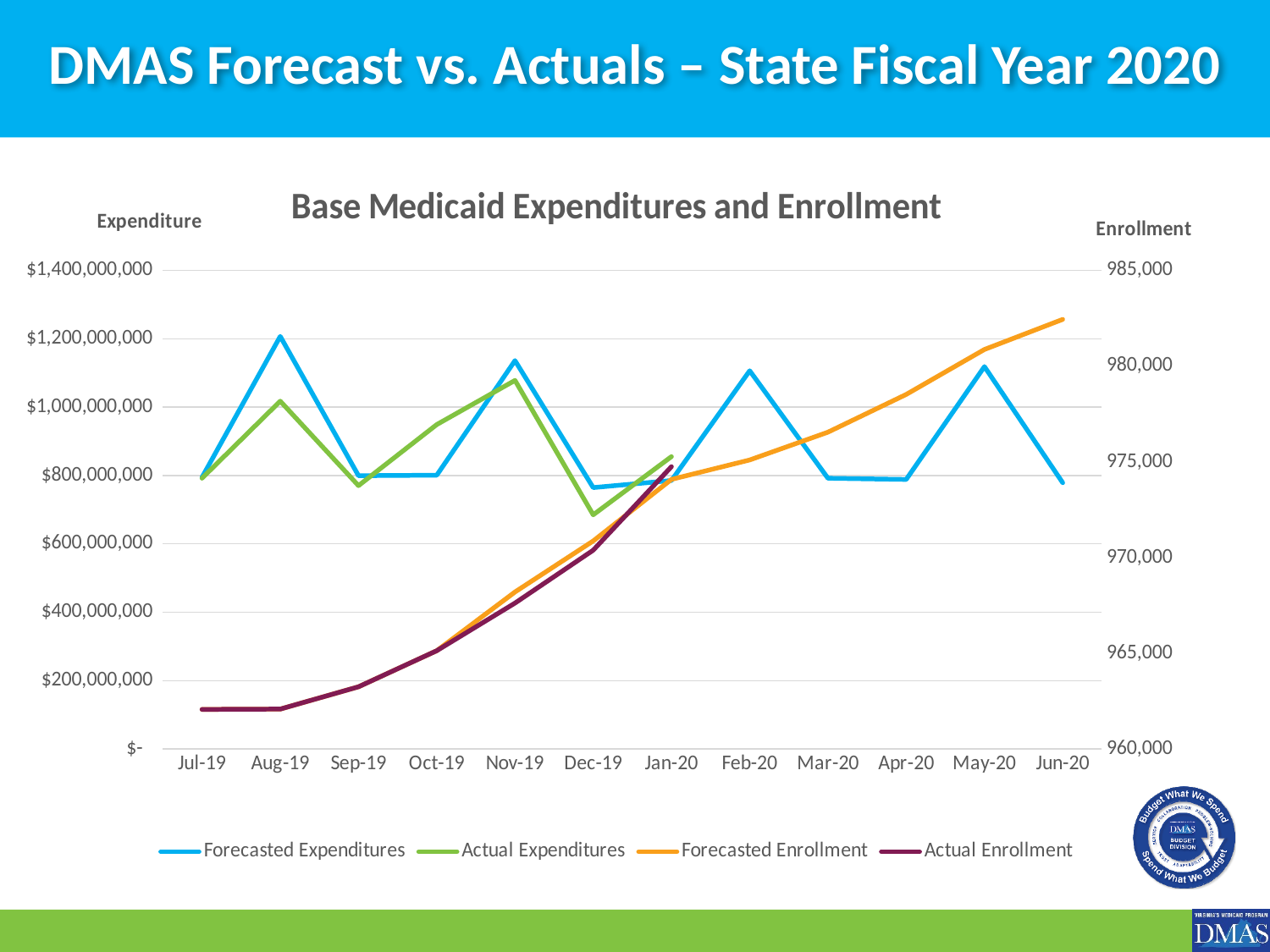
What kind of chart is shown on the slide? Line chart How many months are shown on the x axis? 12 What is the label of the right-hand vertical axis? Enrollment Is the Forecasted Enrollment value for Jun-20 greater or less than 980,000? greater Does the Forecasted Enrollment line rise or fall from Jul-19 to Jun-20? Rise What is the title of the chart? Base Medicaid Expenditures and Enrollment In Oct-19, which is larger: Forecasted Expenditures or Actual Expenditures? Actual Expenditures Is the Forecasted Expenditures value for Aug-19 greater or less than $1,000,000,000? greater In which month is the Forecasted Expenditures value highest? Aug-19 Is the Actual Expenditures value for Dec-19 greater or less than $800,000,000? less How many series does the legend list? 4 In which month is the Actual Expenditures value lowest? Dec-19